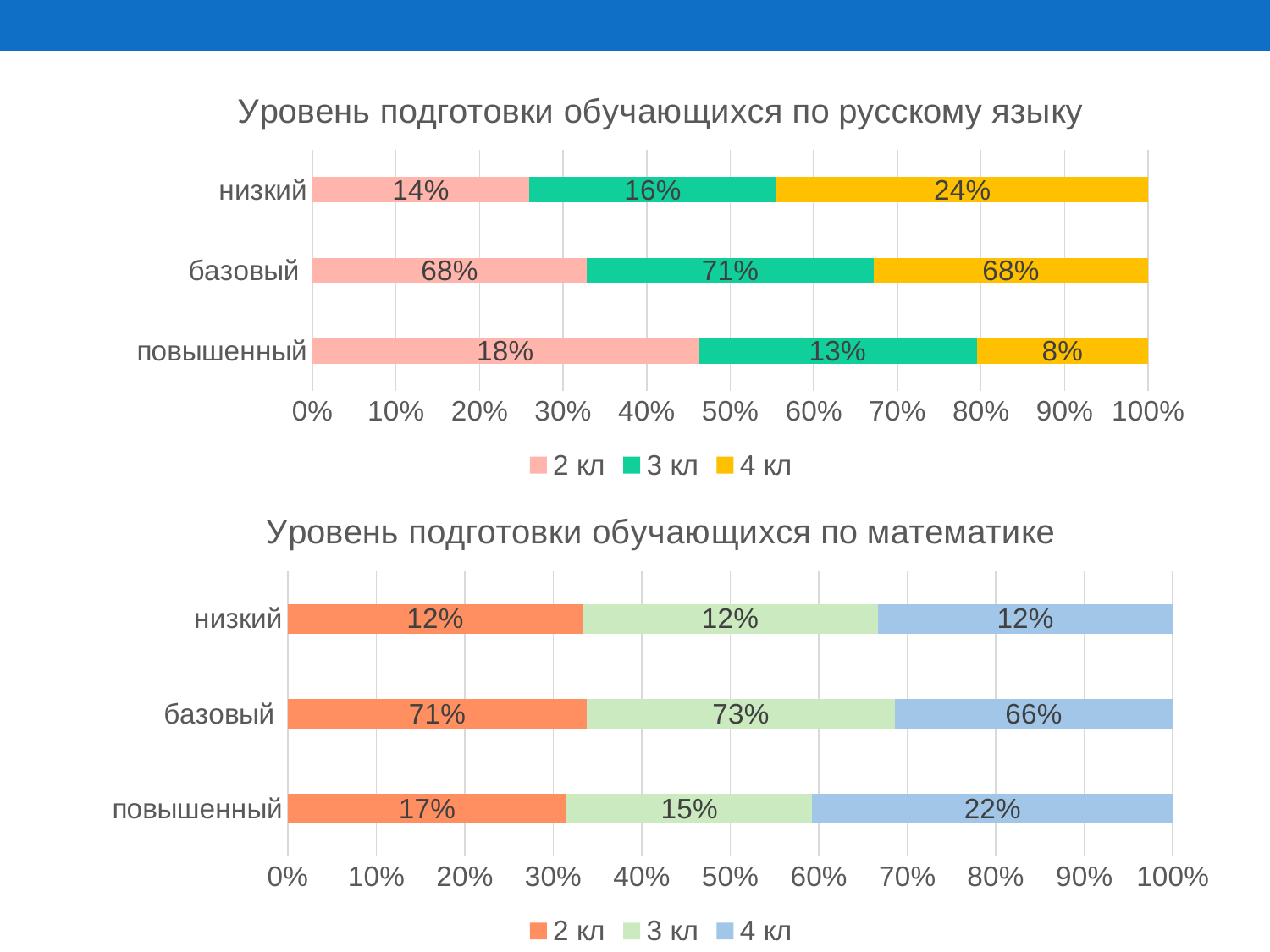
In the chart 'Уровень подготовки обучающихся по русскому языку', what is the value for 3 кл in the 'базовый' category? 71% In the chart 'Уровень подготовки обучающихся по русскому языку', what is the value for 4 кл in the 'низкий' category? 24% In the chart 'Уровень подготовки обучающихся по математике', which class has the lowest value in the 'базовый' category? 4 кл How many categories are shown on the y axis of the chart 'Уровень подготовки обучающихся по математике'? 3 In the chart 'Уровень подготовки обучающихся по математике', what is the value for 4 кл in the 'повышенный' category? 22% In the chart 'Уровень подготовки обучающихся по русскому языку', which class has the highest value in the 'повышенный' category? 2 кл What type of chart is 'Уровень подготовки обучающихся по русскому языку'? Stacked bar chart In the chart 'Уровень подготовки обучающихся по русскому языку', what is the difference between the 2 кл and 4 кл values in the 'повышенный' category? 10% In the chart 'Уровень подготовки обучающихся по математике', what is the difference between the 4 кл and 3 кл values in the 'повышенный' category? 7% In the chart 'Уровень подготовки обучающихся по математике', what is the value for 2 кл in the 'базовый' category? 71% In the chart 'Уровень подготовки обучающихся по русскому языку', how many series does the legend list? 3 In the chart 'Уровень подготовки обучающихся по математике', is the 3 кл value in the 'базовый' category larger or smaller than the 4 кл value? larger